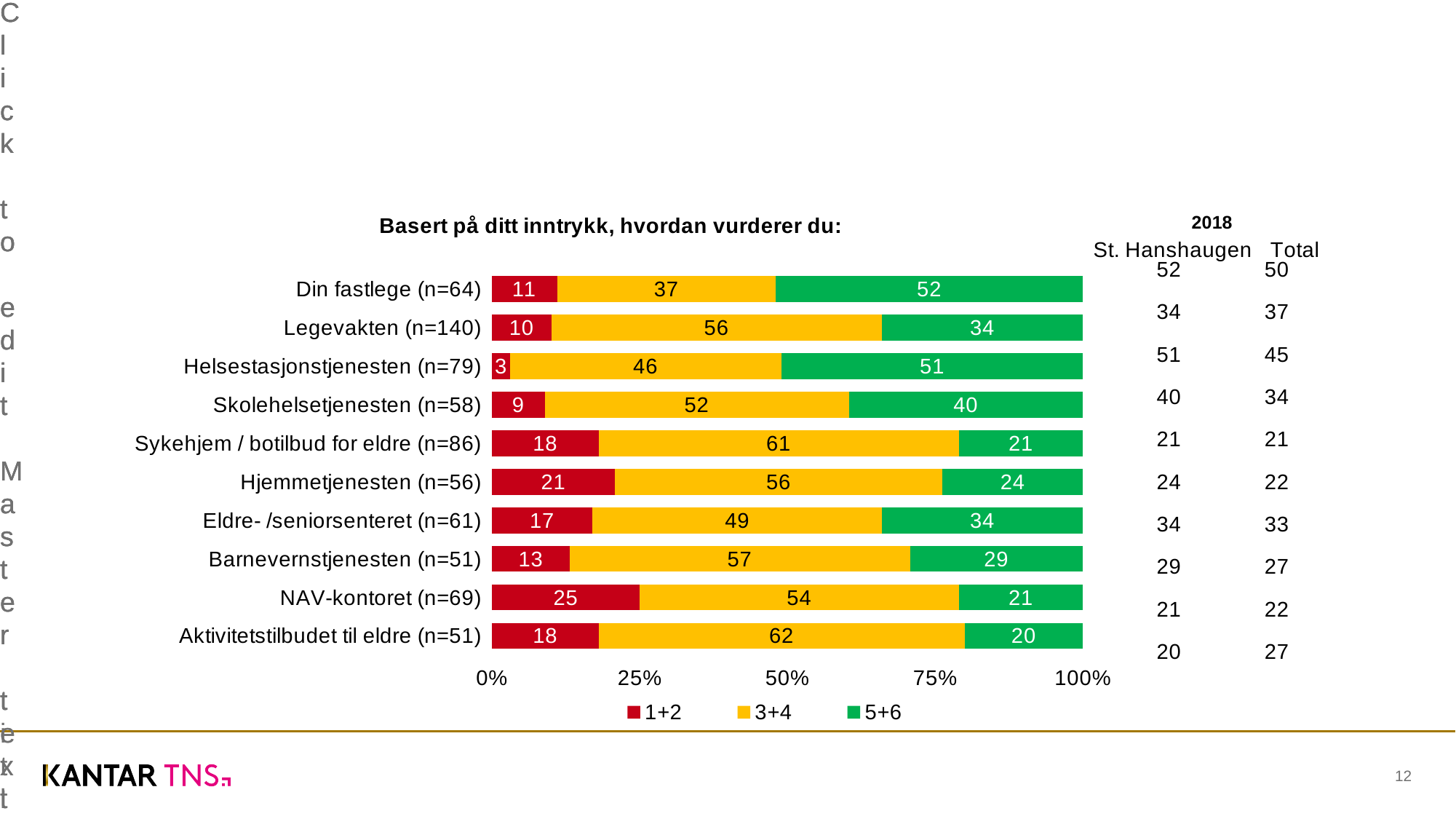
Which category has the highest 3+4 value? Aktivitetstilbudet til eldre (n=51) What is the difference between the 5+6 value and the 1+2 value for Din fastlege (n=64)? 41 What kind of chart is shown on the slide? Stacked bar chart What is the value of the 5+6 segment for Din fastlege (n=64)? 52 What is the value of the 1+2 segment for NAV-kontoret (n=69)? 25 Which category has the highest 1+2 value? NAV-kontoret (n=69) How many categories are shown in the chart? 10 Which category has the lowest 1+2 value? Helsestasjonstjenesten (n=79) What is the value of the 3+4 segment for Sykehjem / botilbud for eldre (n=86)? 61 What is the total of the stacked bar for Hjemmetjenesten (n=56)? 101 How many series does the legend list? 3 Which has a larger 3+4 value, Legevakten (n=140) or Din fastlege (n=64)? Legevakten (n=140)